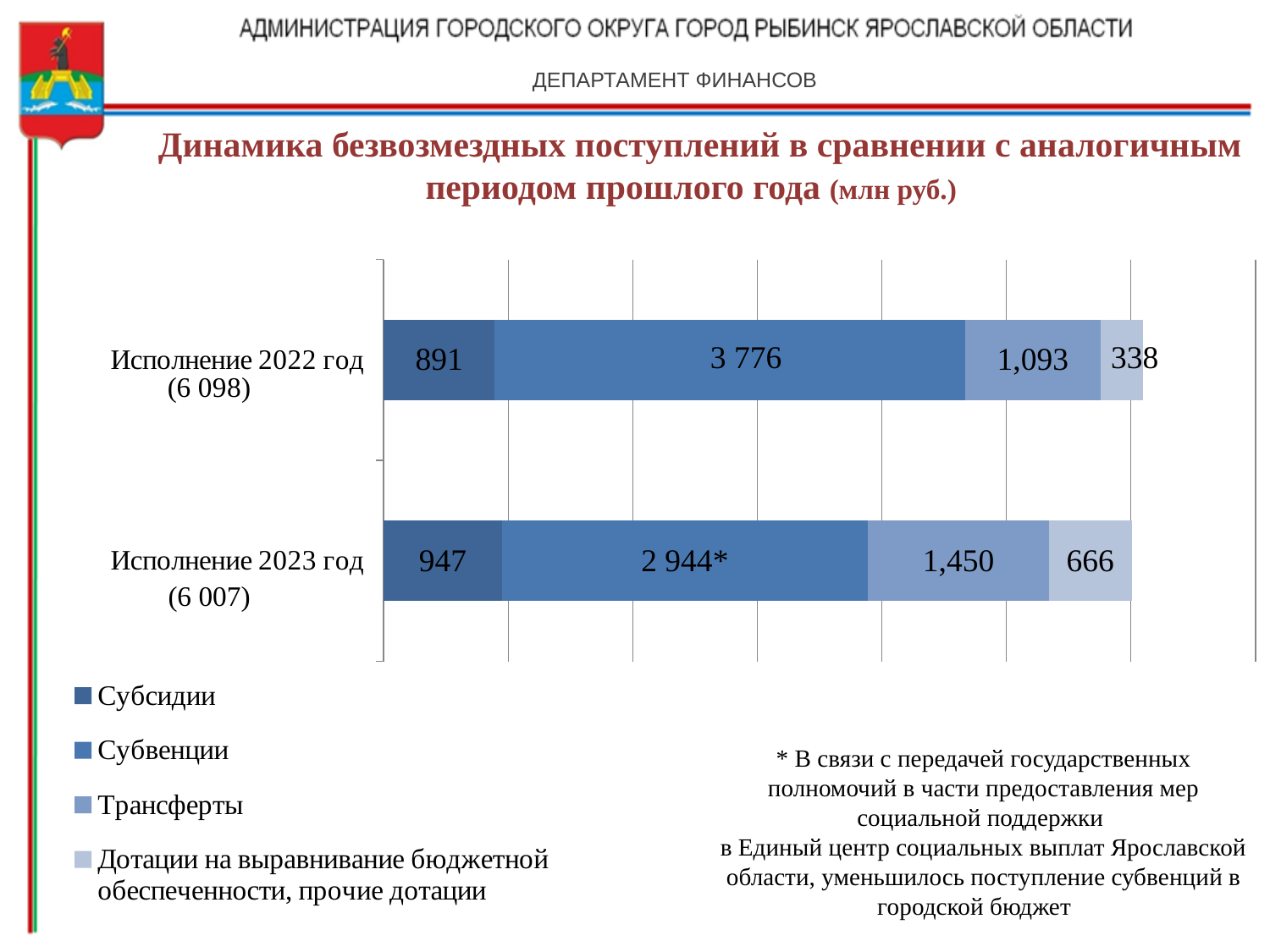
What is the value of Трансферты for Исполнение 2023 год? 1,450 Which series has the smallest value in the Исполнение 2022 год bar? Дотации на выравнивание бюджетной обеспеченности, прочие дотации What is the value of Субсидии for Исполнение 2022 год? 891 What is the difference between the Субвенции values for 2022 and 2023? 832 Which series has the largest value in the Исполнение 2022 год bar? Субвенции What is the value of Субвенции for Исполнение 2022 год? 3 776 Which year has the larger Трансферты value, 2022 or 2023? 2023 What is the value of Дотации на выравнивание бюджетной обеспеченности, прочие дотации for Исполнение 2023 год? 666 How many series does the legend list? 4 How many bars (categories) are plotted in the chart? 2 What kind of chart is shown on the slide? Stacked bar chart What is the total of the stacked bar for Исполнение 2023 год? 6 007